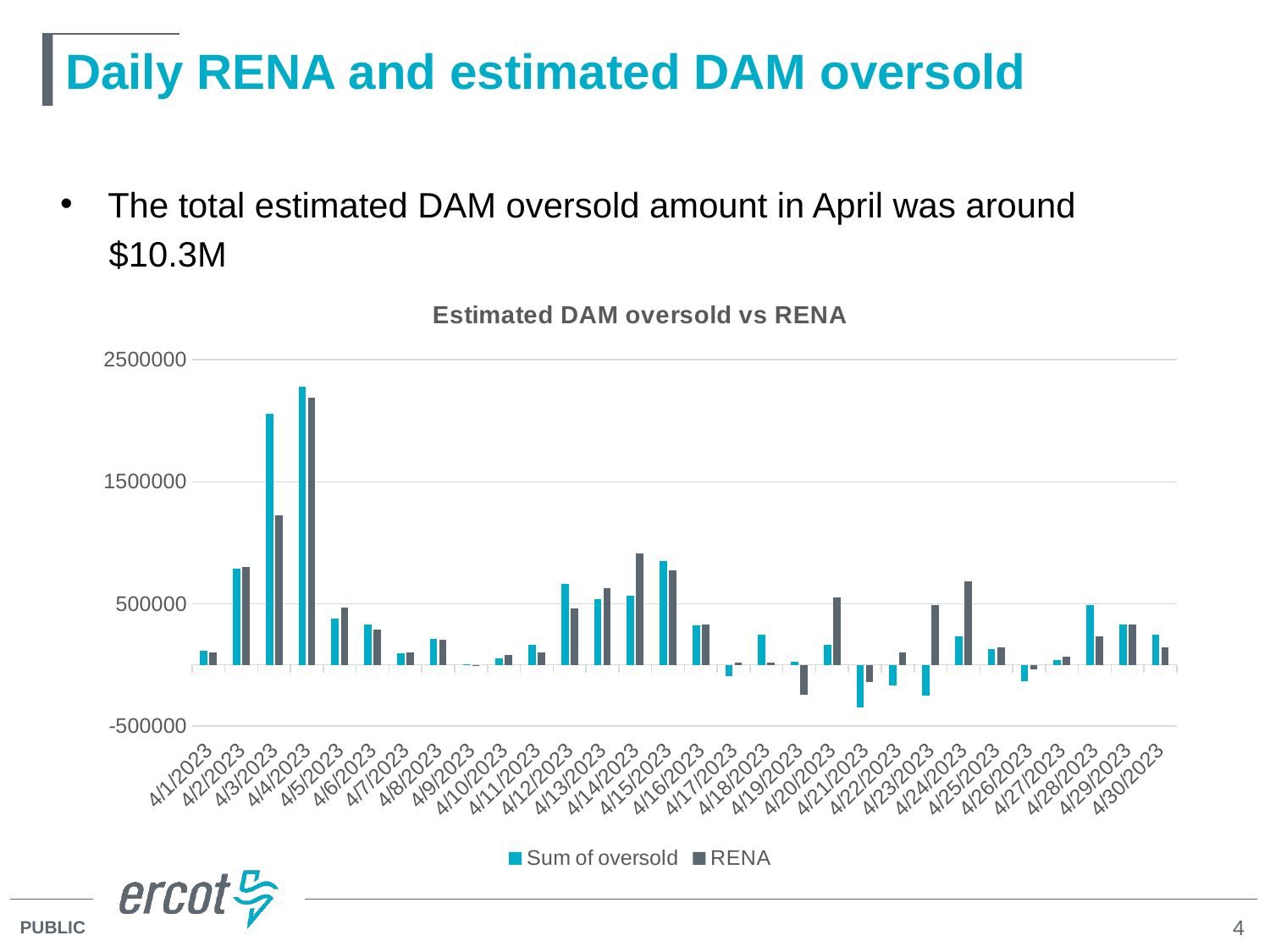
On which date is the Sum of oversold value lowest? 4/21/2023 What is the title of the chart? Estimated DAM oversold vs RENA What are the two series named in the legend? Sum of oversold and RENA On 4/3/2023, which is larger: Sum of oversold or RENA? Sum of oversold Is the Sum of oversold value for 4/3/2023 greater or less than 1500000? greater What kind of chart is shown on the slide? Bar chart On which date is the RENA value highest? 4/4/2023 How many dates are shown along the x axis of the chart? 30 How many series does the chart's legend list? 2 On which date is the Sum of oversold value highest? 4/4/2023 Is the Sum of oversold value for 4/5/2023 greater or less than 500000? less On 4/24/2023, which is larger: Sum of oversold or RENA? RENA